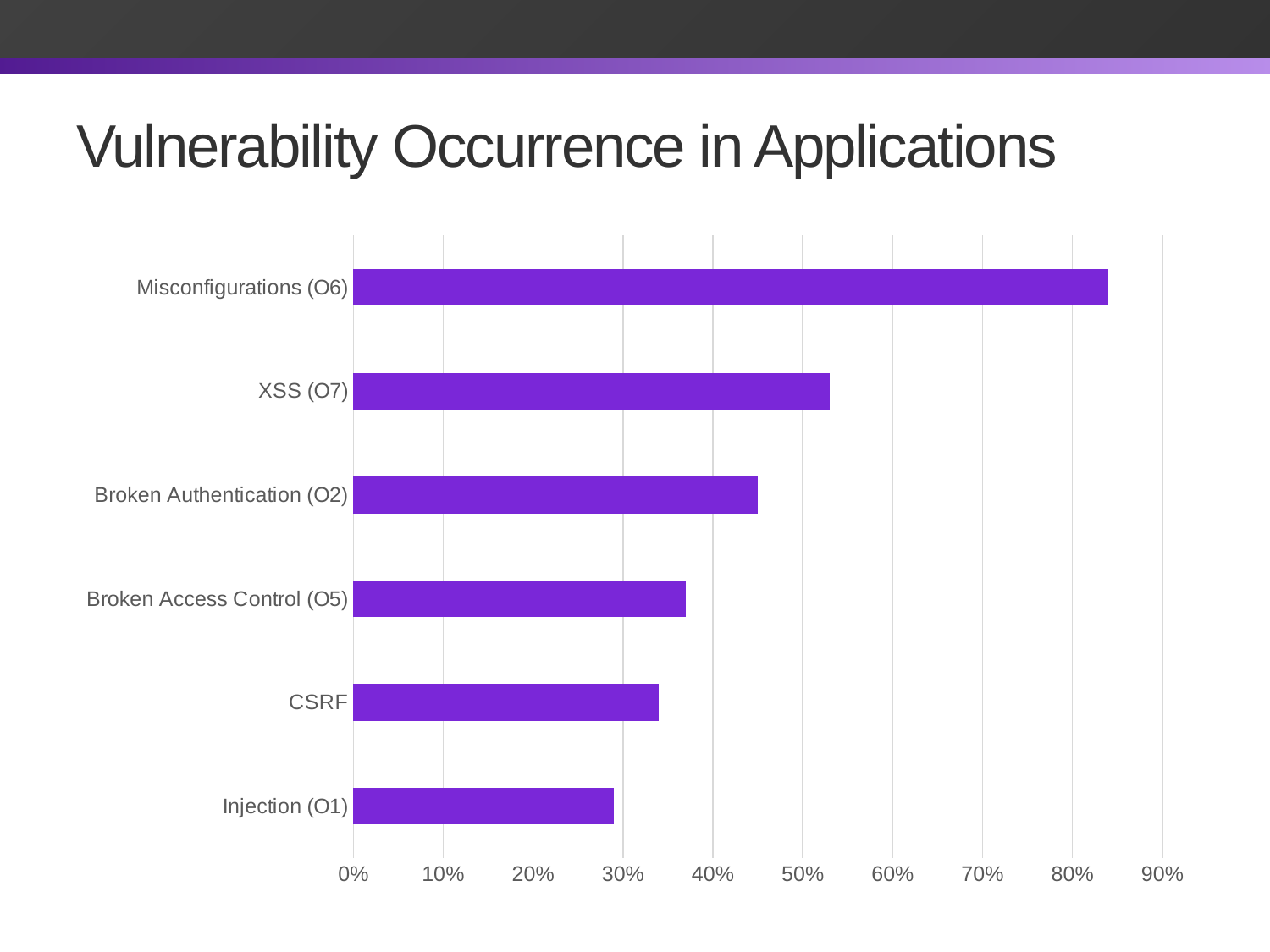
Is the value for Broken Authentication (O2) greater or less than 50%? less Which has a higher occurrence, XSS (O7) or Broken Authentication (O2)? XSS (O7) Which vulnerability category has the lowest occurrence? Injection (O1) Which has a higher occurrence, Injection (O1) or Broken Access Control (O5)? Broken Access Control (O5) How many vulnerability categories are plotted in the chart? 6 Is the value for XSS (O7) greater or less than 50%? greater What is the title of the chart? Vulnerability Occurrence in Applications What kind of chart is shown on the slide? Bar chart Which vulnerability category has the highest occurrence? Misconfigurations (O6) Is the value for CSRF greater or less than 30%? greater